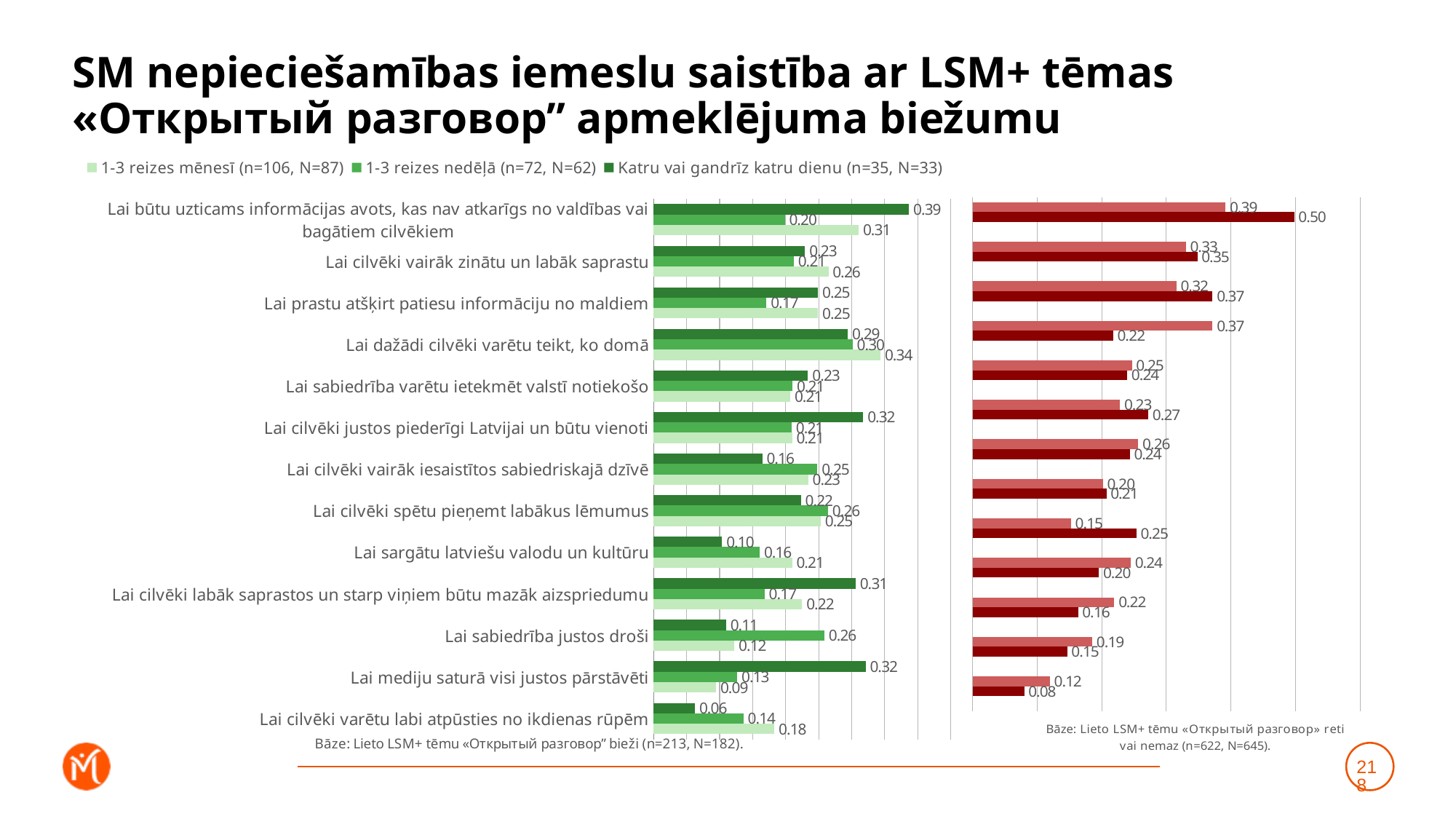
In the left (green) chart, what is the value for 'Katru vai gandrīz katru dienu' for 'Lai būtu uzticams informācijas avots, kas nav atkarīgs no valdības vai bagātiem cilvēkiem'? 0.39 In the left (green) chart, which category has the lowest value for 'Katru vai gandrīz katru dienu'? Lai cilvēki varētu labi atpūsties no ikdienas rūpēm In the right (red) chart, what is the value of the darker red bar for 'Lai būtu uzticams informācijas avots, kas nav atkarīgs no valdības vai bagātiem cilvēkiem'? 0.50 In the left (green) chart, what is the difference between the 'Katru vai gandrīz katru dienu' and '1-3 reizes nedēļā' values for 'Lai mediju saturā visi justos pārstāvēti'? 0.19 How many series does the legend of the left (green) chart list? 3 In the left (green) chart, for 'Lai sargātu latviešu valodu un kultūru', which series has the larger value: '1-3 reizes mēnesī' or 'Katru vai gandrīz katru dienu'? 1-3 reizes mēnesī How many categories are shown in the left (green) chart? 13 In the left (green) chart, what is the value for '1-3 reizes nedēļā' for 'Lai sabiedrība justos droši'? 0.26 In the left (green) chart, what is the value for '1-3 reizes mēnesī' for 'Lai dažādi cilvēki varētu teikt, ko domā'? 0.34 In the right (red) chart, for 'Lai dažādi cilvēki varētu teikt, ko domā', which bar is larger: the lighter red or the darker red? lighter red In the right (red) chart, which category has the highest value for the darker red bar? Lai būtu uzticams informācijas avots, kas nav atkarīgs no valdības vai bagātiem cilvēkiem What type of chart is the left (green) chart? bar chart